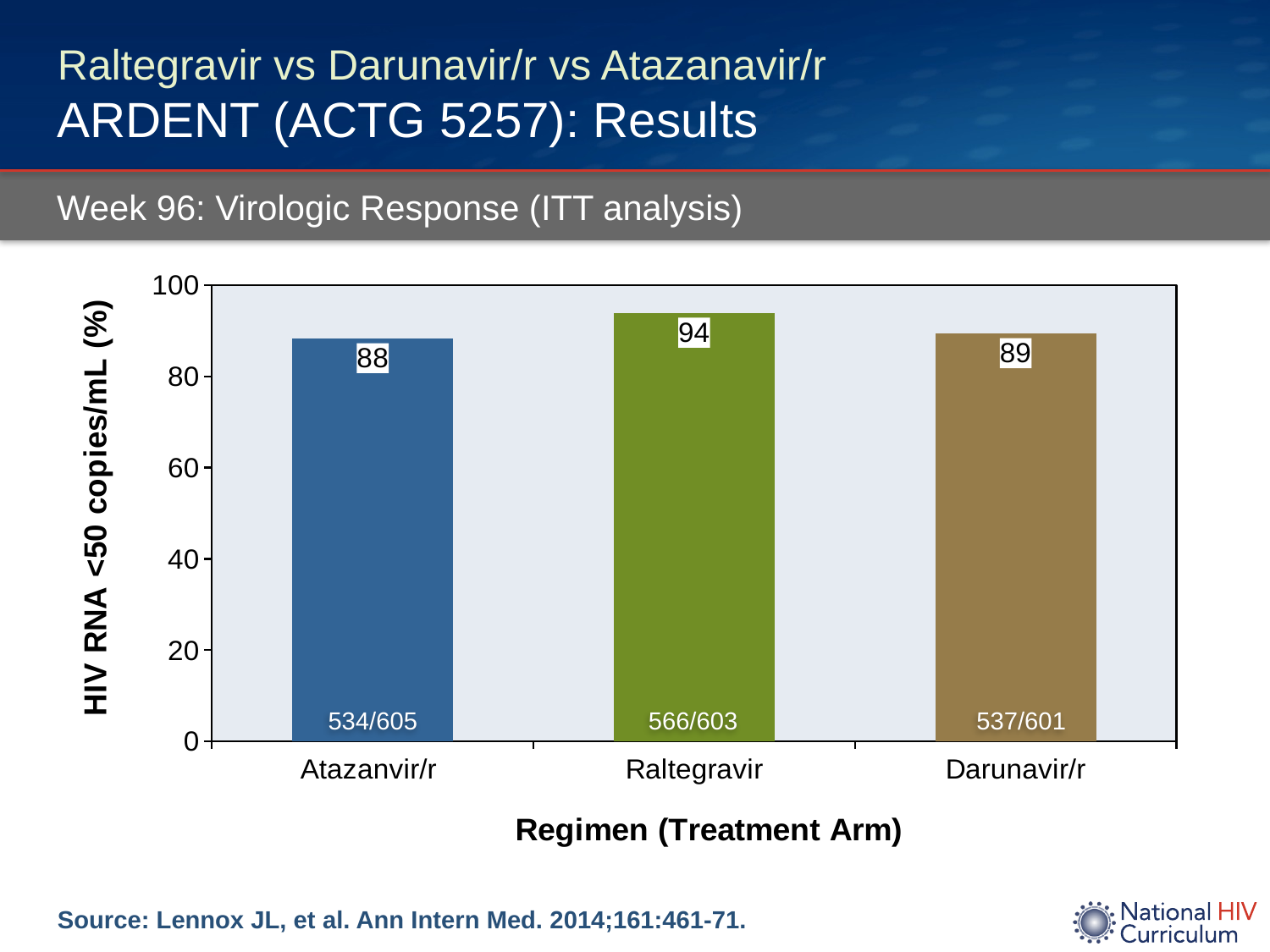
What is the value for Darunavir/r? 89 Which is larger, the value for Raltegravir or the value for Atazanvir/r? Raltegravir Is the value for Darunavir/r greater or less than 80? greater What is the value for Raltegravir? 94 What is the difference between the values for Raltegravir and Atazanvir/r? 6 What is the value for Atazanvir/r? 88 Which treatment arm has the lowest value? Atazanvir/r What kind of chart is shown on the slide? bar chart Which treatment arm has the highest value? Raltegravir What fraction is printed at the bottom of the Raltegravir bar? 566/603 How many treatment arms are shown on the chart? 3 What is the difference between the values for Raltegravir and Darunavir/r? 5